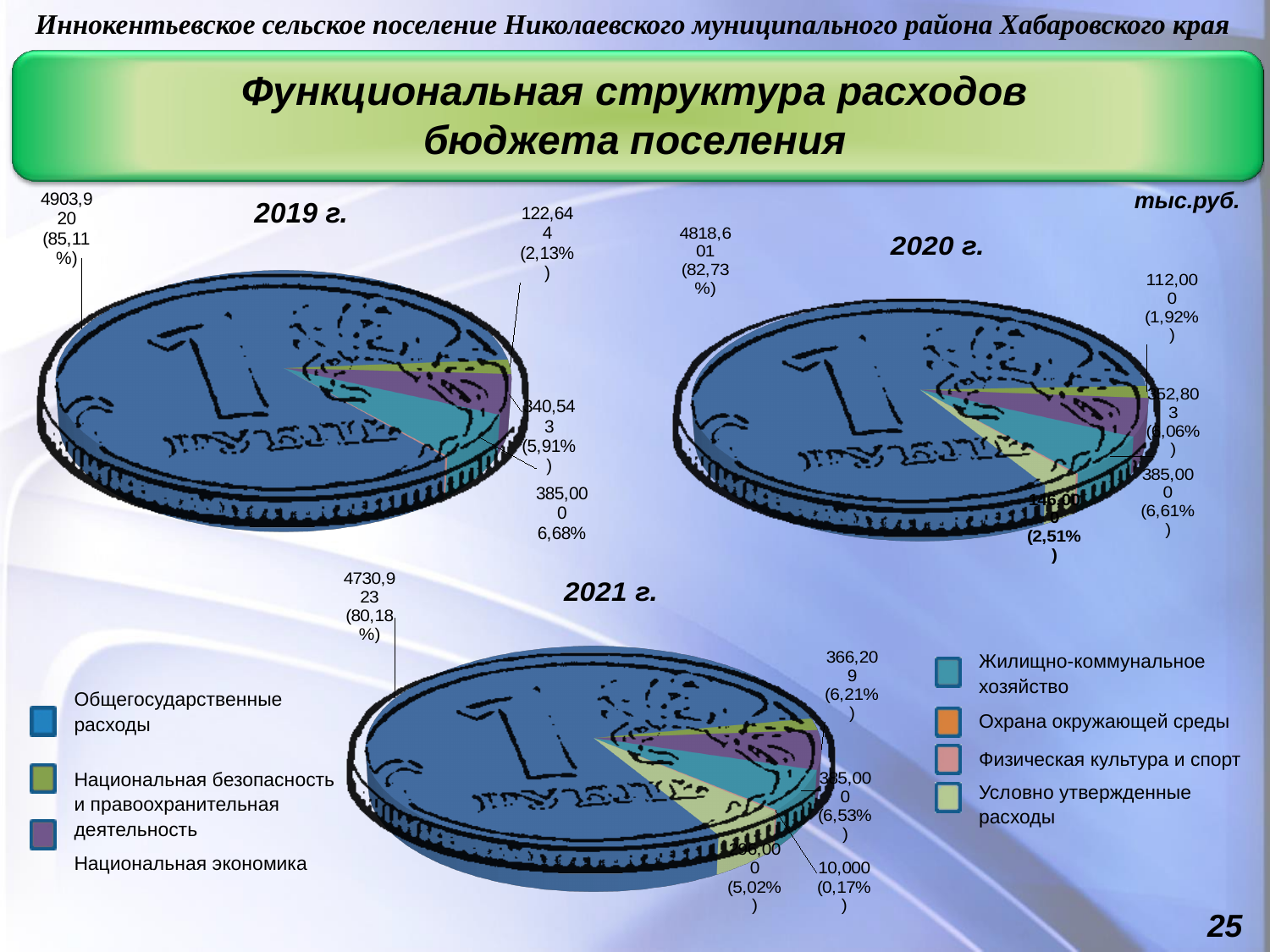
In the 2021 pie chart, what is the share of the smallest labelled slice? 0,17% By how many percentage points does the share of the largest slice in 2019 (85,11%) exceed that in 2021 (80,18%)? 4,93 In the 2020 pie chart, what is the share of the largest slice? 82,73% How many pie charts are shown on the slide? 3 In the 2021 pie chart, what is the value of the largest slice? 4730,923 Is the share of the largest slice bigger in the 2019 pie chart or in the 2021 pie chart? 2019 Which expenditure category has the largest share in the 2019 pie chart? Общегосударственные расходы In the 2019 pie chart, what is the share of the largest slice? 85,11% What kind of chart is used to show the expenditure structure for each year on this slide? Pie chart In what units are the values on the pie charts given? тыс.руб. In the 2019 pie chart, what is the value of the largest slice? 4903,920 How many expenditure categories does the legend list? 7